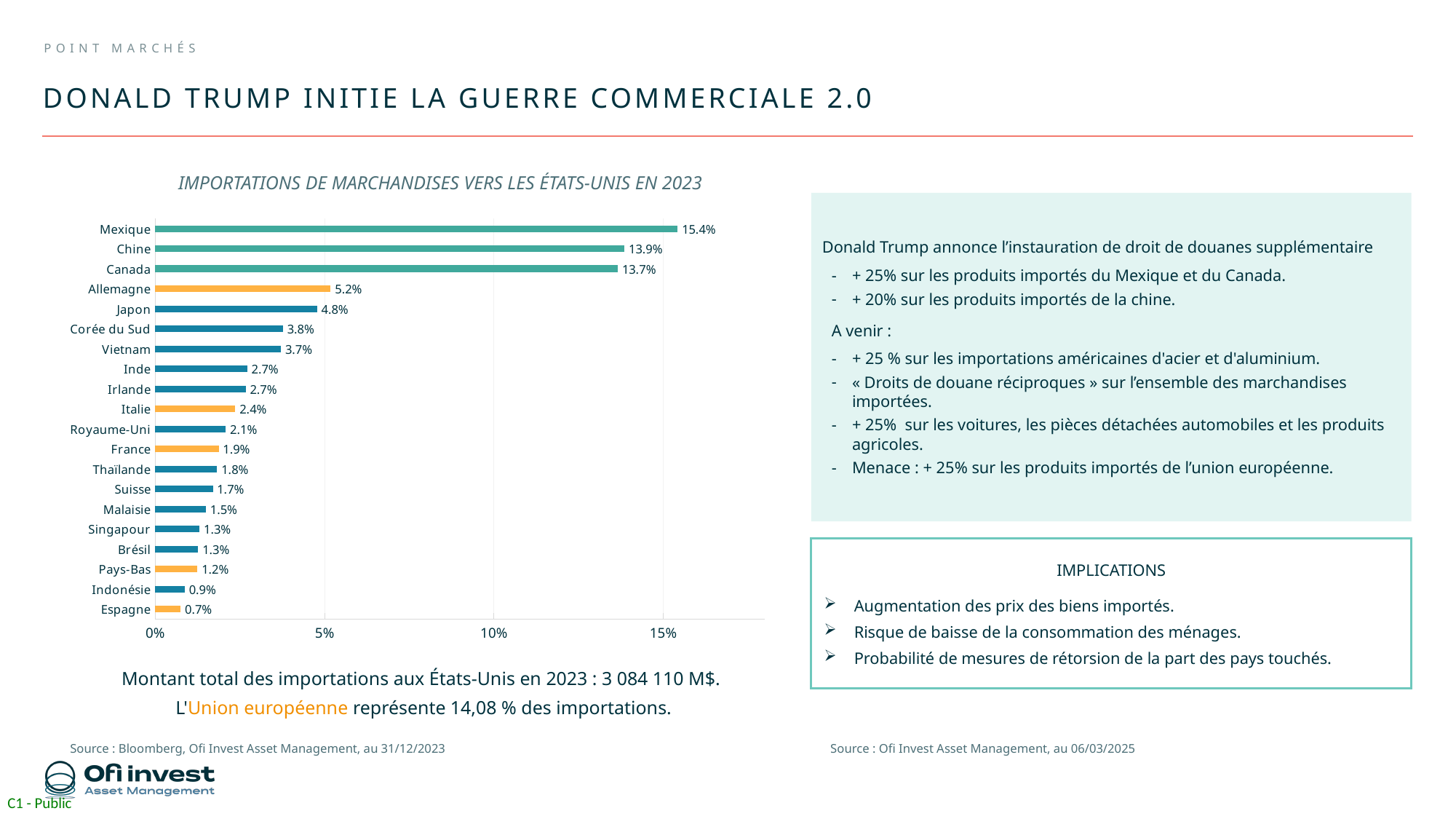
Which is larger, the value for Japon or the value for Corée du Sud? Japon Is the value for Canada greater or less than 10%? greater What is the value shown for Mexique? 15.4% What is the difference between the values for Mexique and Allemagne? 10.2% What is the title of the chart? IMPORTATIONS DE MARCHANDISES VERS LES ÉTATS-UNIS EN 2023 How many countries are shown in the chart? 20 What type of chart is shown on the slide? Bar chart Which country has the highest share of imports in the chart? Mexique What is the difference between the values for Chine and Canada? 0.2% Which country has the lowest share of imports in the chart? Espagne What is the value shown for France? 1.9% What is the value shown for Allemagne? 5.2%